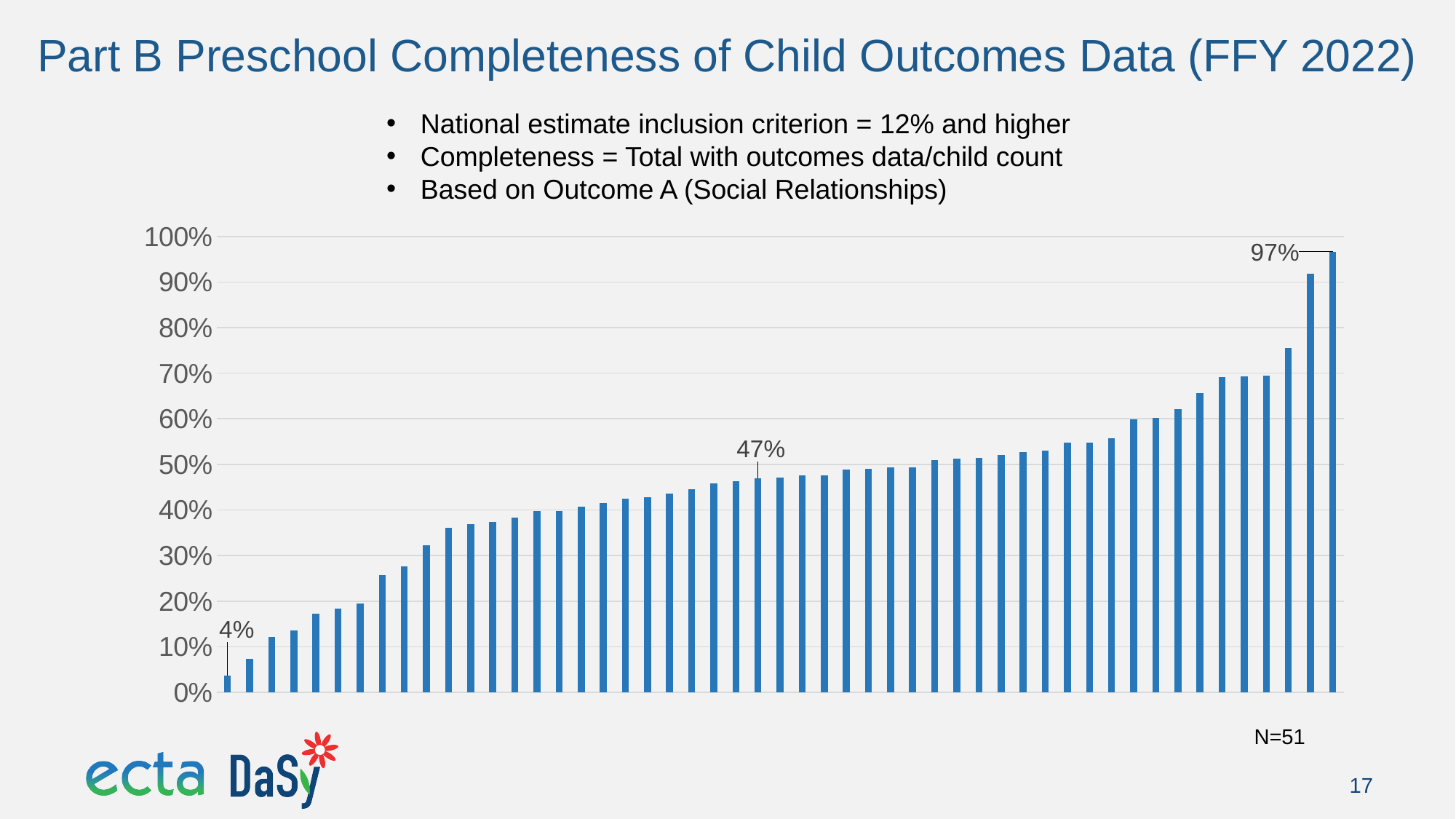
How many states/entities (N) are represented in the chart? 51 What kind of chart is shown on the slide? bar chart Do the bar values rise or fall from left to right along the x axis? rise Is the value of the second-highest bar greater or less than 80%? greater What is the maximum value shown on the y axis? 100% Is the value of the second-lowest bar greater or less than 10%? less What is the title of the slide containing the chart? Part B Preschool Completeness of Child Outcomes Data (FFY 2022) What value is labeled on the middle bar of the chart? 47% Which is larger, the value of the leftmost bar or the value of the rightmost bar? the rightmost bar What is the lowest completeness value labeled on the chart? 4% What is the difference between the highest labeled value (97%) and the lowest labeled value (4%)? 93 percentage points What is the highest completeness value labeled on the chart? 97%